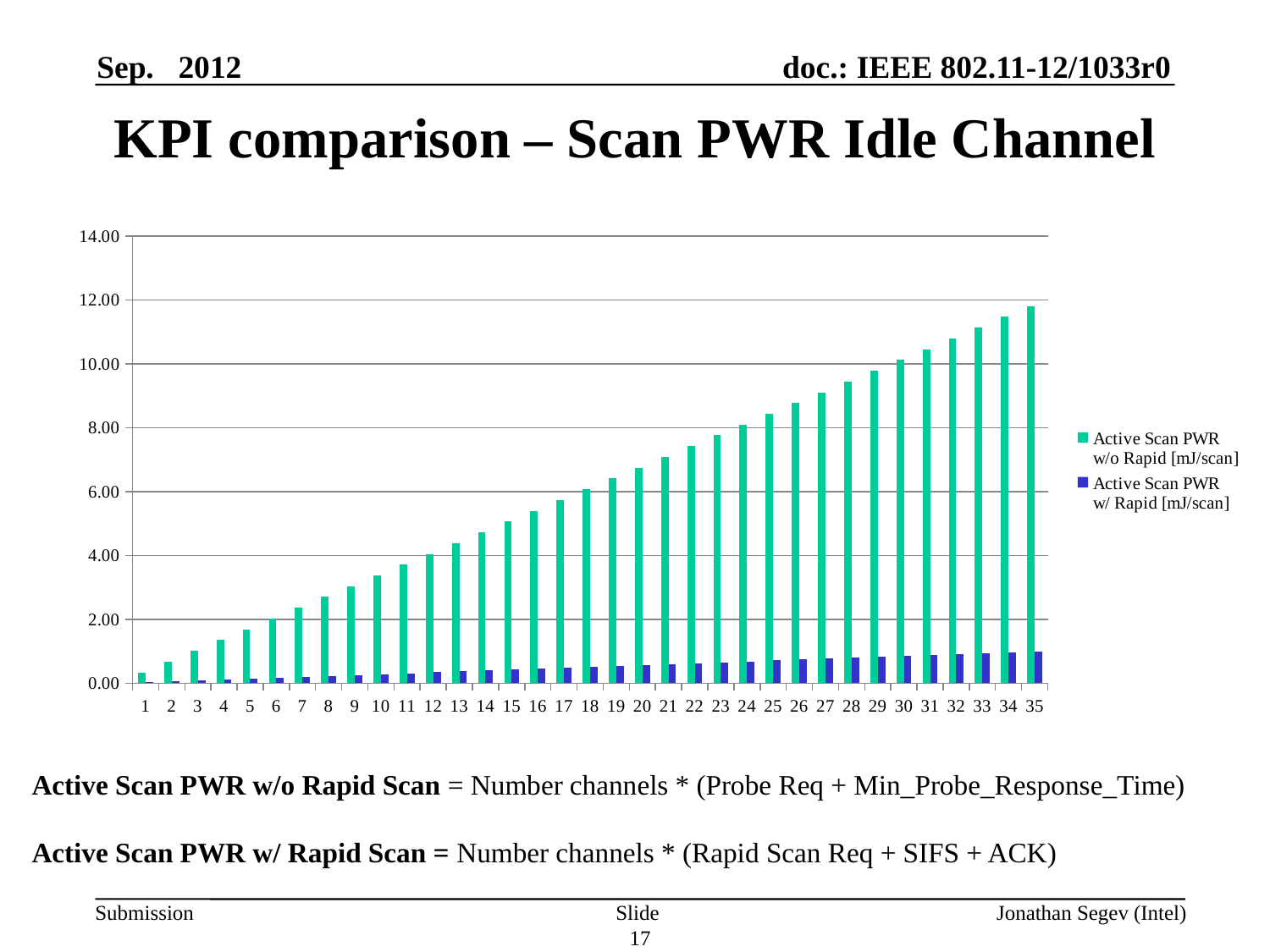
Which category has the highest value for Active Scan PWR w/o Rapid [mJ/scan]? 35 Do the values for Active Scan PWR w/o Rapid [mJ/scan] rise or fall as the category number increases along the x axis? rise What colour are the bars for the Active Scan PWR w/ Rapid [mJ/scan] series? blue How many categories are shown along the x axis? 35 How many series does the legend list? 2 Is the value for Active Scan PWR w/o Rapid [mJ/scan] at category 10 greater or less than 4.00? less At category 20, which series has the larger value: Active Scan PWR w/o Rapid [mJ/scan] or Active Scan PWR w/ Rapid [mJ/scan]? Active Scan PWR w/o Rapid [mJ/scan] Which is larger: the Active Scan PWR w/o Rapid [mJ/scan] value at category 35 or at category 5? category 35 Which category has the lowest value for Active Scan PWR w/o Rapid [mJ/scan]? 1 Is the value for Active Scan PWR w/o Rapid [mJ/scan] at category 35 greater or less than 10.00? greater What kind of chart is shown on the slide? bar chart Is the value for Active Scan PWR w/ Rapid [mJ/scan] at category 35 greater or less than 2.00? less